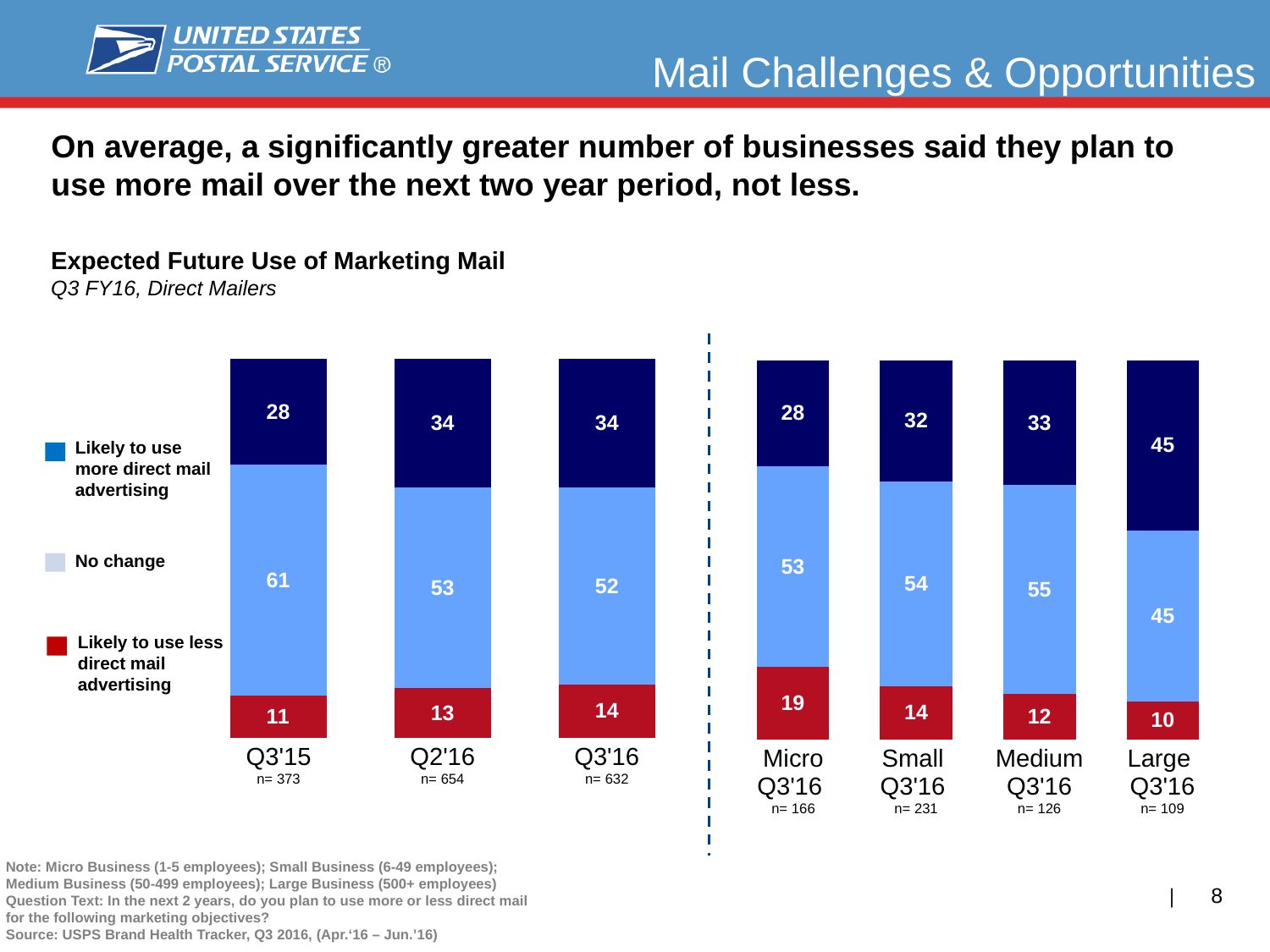
How many series does the legend of the Expected Future Use of Marketing Mail chart list? 3 In the Expected Future Use of Marketing Mail chart, is the 'Likely to use more' value larger for Small or Medium businesses? Medium What is the sample size (n) shown for the Q2'16 bar in the Expected Future Use of Marketing Mail chart? n= 654 In the Expected Future Use of Marketing Mail chart, which business size has the highest 'Likely to use more direct mail advertising' value? Large In the Expected Future Use of Marketing Mail chart, what percentage of Q3'15 direct mailers said they were likely to use more direct mail advertising? 28 In the Expected Future Use of Marketing Mail chart, what is the 'No change' value for Large businesses in Q3'16? 45 In the Expected Future Use of Marketing Mail chart, what is the difference between the 'No change' values for Q3'15 and Q3'16? 9 What type of chart is the Expected Future Use of Marketing Mail chart? Stacked bar chart How many bars are shown in the Expected Future Use of Marketing Mail chart? 7 In the Expected Future Use of Marketing Mail chart, does the 'Likely to use less direct mail advertising' value rise or fall from Q3'15 to Q3'16? Rise In the Expected Future Use of Marketing Mail chart, which business size has the lowest 'Likely to use less direct mail advertising' value? Large In the Expected Future Use of Marketing Mail chart, what is the 'Likely to use less direct mail advertising' value for Micro businesses? 19